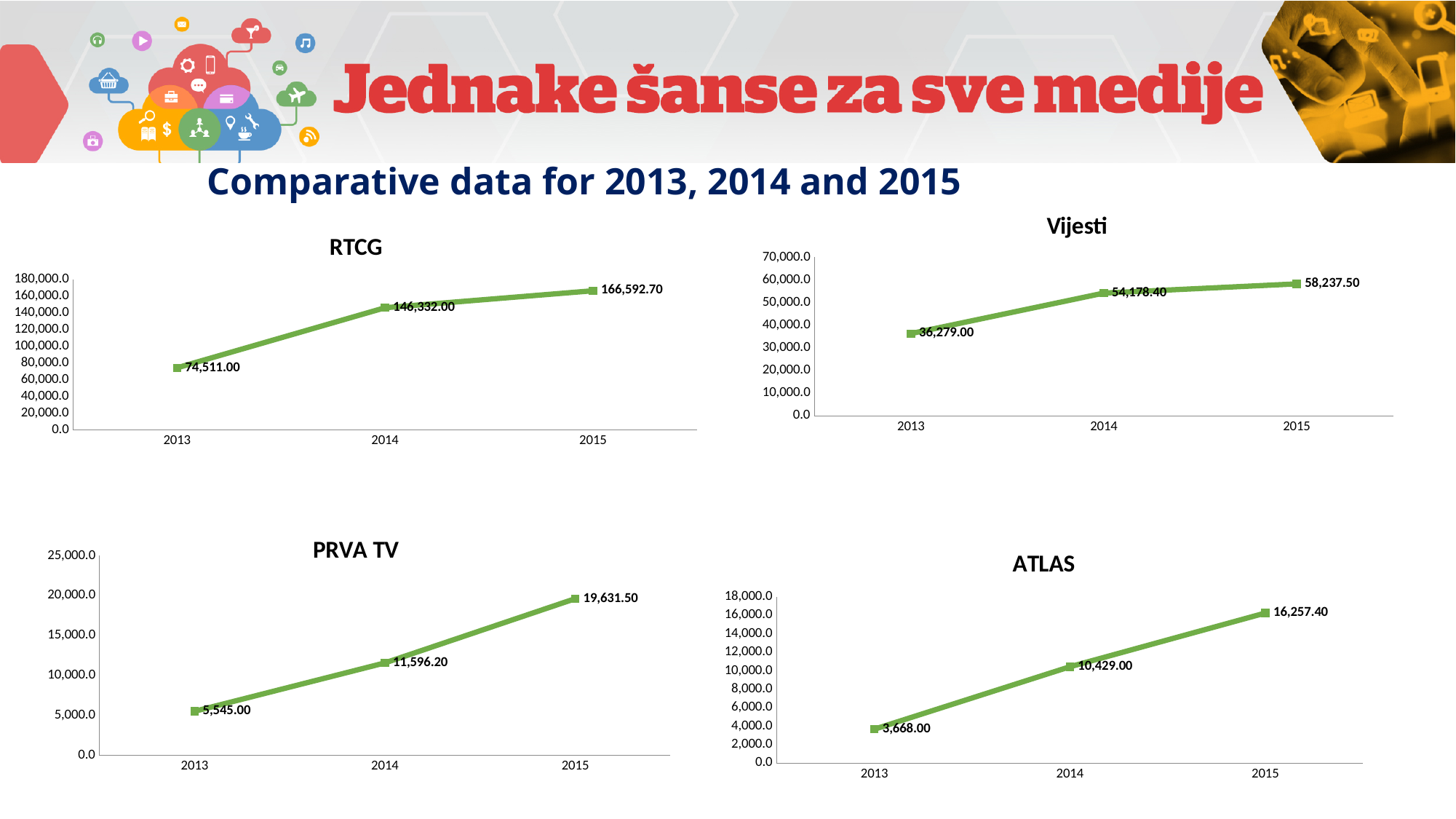
How many data points are plotted in the ATLAS chart? 3 In the Vijesti chart, what is the value for 2013? 36,279.00 In the PRVA TV chart, what is the difference between the 2015 and 2014 values? 8,035.30 In the Vijesti chart, do the values rise or fall from 2013 to 2015? Rise In the ATLAS chart, what is the difference between the 2015 and 2013 values? 12,589.40 In the RTCG chart, what is the value for 2015? 166,592.70 In the RTCG chart, is the value for 2014 larger than the value for 2013? Yes In the PRVA TV chart, what is the value for 2014? 11,596.20 In the RTCG chart, which year has the lowest value? 2013 What kind of chart is the PRVA TV chart? Line chart In the ATLAS chart, what is the value for 2015? 16,257.40 In the Vijesti chart, which year has the highest value? 2015